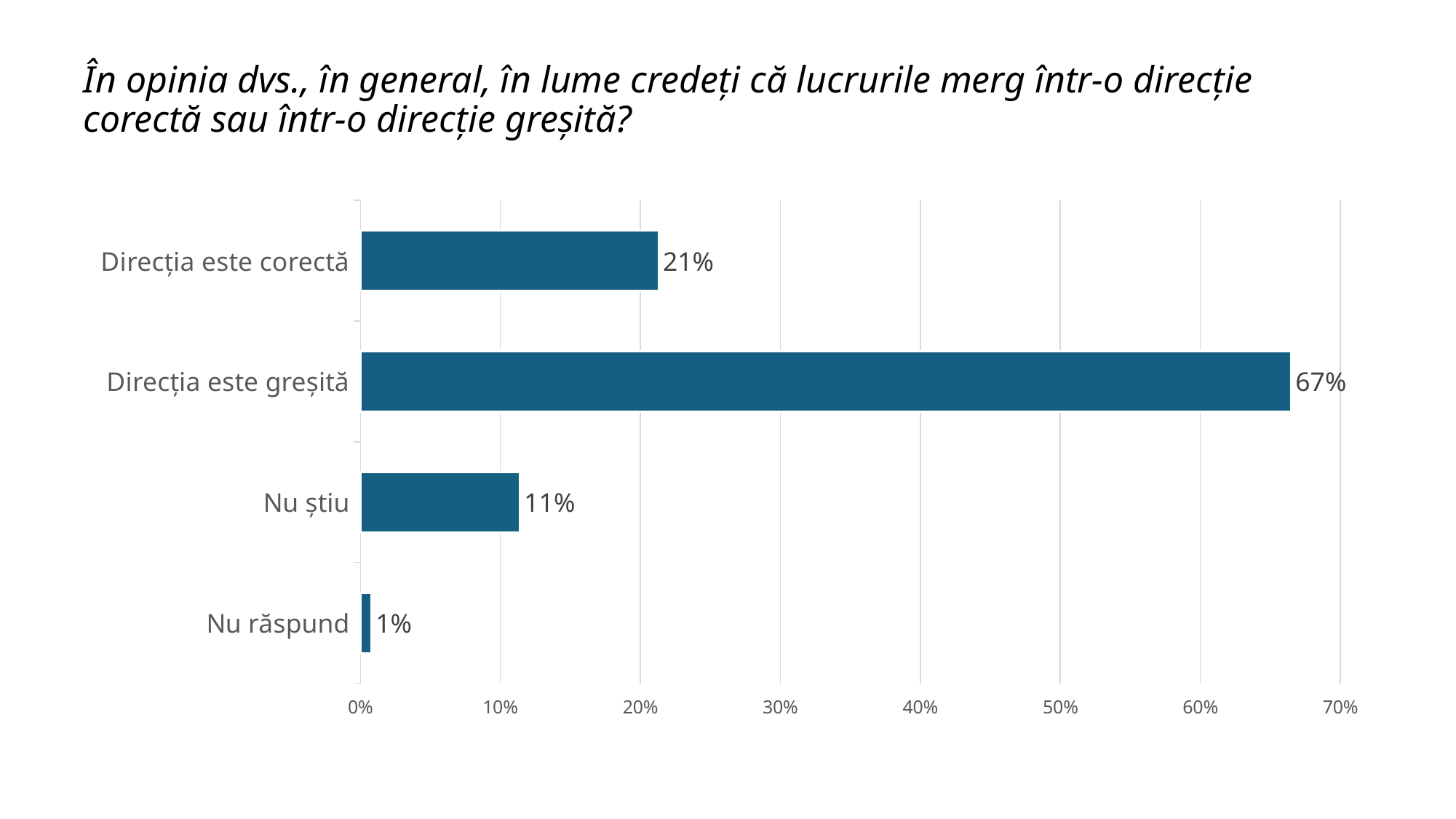
What is the value for "Nu răspund"? 1% What is the value for "Direcția este corectă"? 21% What is the value for "Direcția este greșită"? 67% Which is larger, the value for "Direcția este corectă" or the value for "Nu știu"? Direcția este corectă How many categories are shown in the chart? 4 Is the value for "Direcția este greșită" greater or less than 60%? greater What kind of chart is shown on the slide? bar chart Which category has the highest value? Direcția este greșită What is the difference between the values for "Direcția este greșită" and "Direcția este corectă"? 46% Which category has the lowest value? Nu răspund What is the value for "Nu știu"? 11% What is the highest value shown on the x axis? 70%